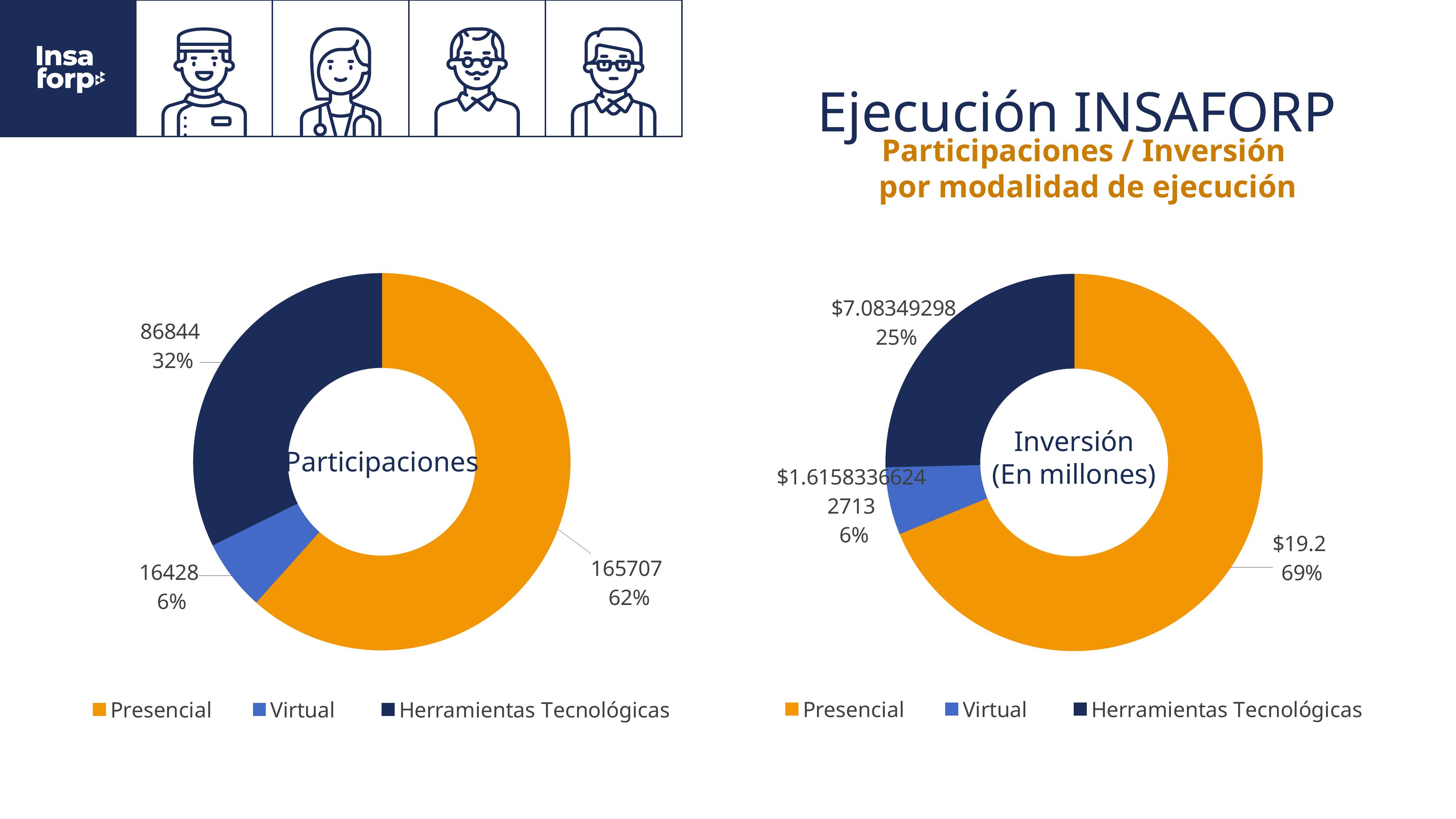
In the Participaciones chart, what share of the total does Herramientas Tecnológicas represent? 32% In the Inversión (En millones) chart, what is the value for Herramientas Tecnológicas? $7.08349298 In the Inversión (En millones) chart, which category has the largest value? Presencial In the Inversión (En millones) chart, what is the value for Presencial? $19.2 In the Participaciones chart, what is the value for Presencial? 165707 What type of chart is the Participaciones chart? Doughnut chart In the Participaciones chart, which category has the smallest value? Virtual In the Participaciones chart, what is the value for Virtual? 16428 In the Participaciones chart, what is the difference between the Presencial and Herramientas Tecnológicas values? 78863 In the Participaciones chart, what is the value for Herramientas Tecnológicas? 86844 In the Participaciones chart, what is the total of all three categories? 268979 In the Inversión (En millones) chart, what share of the total does Presencial represent? 69%